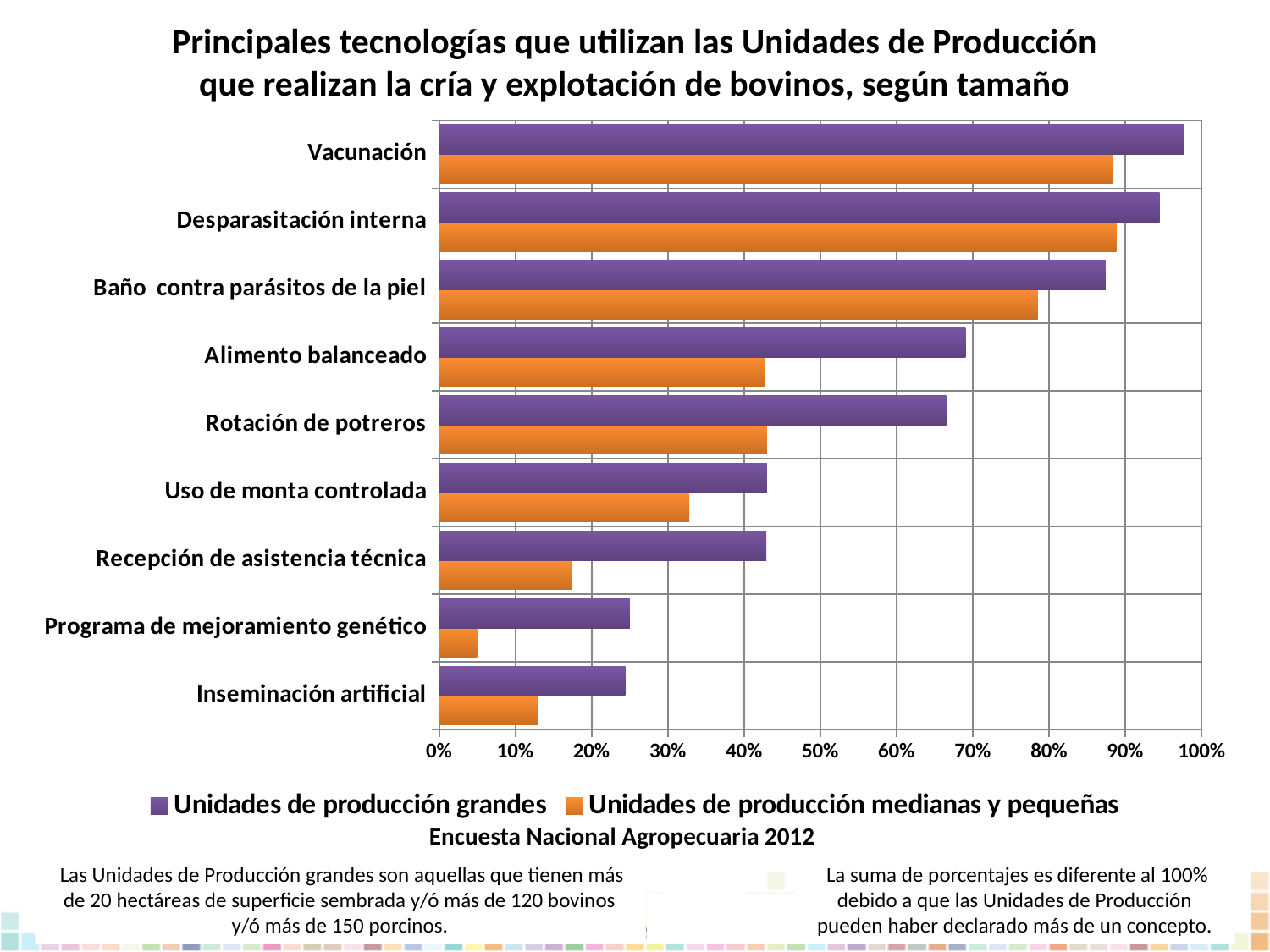
How many series does the legend list? 2 What is the data source cited below the chart? Encuesta Nacional Agropecuaria 2012 Which technology has the lowest value for Unidades de producción medianas y pequeñas? Programa de mejoramiento genético Which colour represents Unidades de producción grandes in the chart? Purple Is the value for Alimento balanceado among Unidades de producción medianas y pequeñas greater or less than 50%? less For Alimento balanceado, which series has the larger value: Unidades de producción grandes or Unidades de producción medianas y pequeñas? Unidades de producción grandes What kind of chart is shown on the slide? Bar chart How many technologies (categories) are listed on the chart? 9 Is the value for Recepción de asistencia técnica among Unidades de producción medianas y pequeñas greater or less than 20%? less Is the value for Vacunación among Unidades de producción grandes greater or less than 90%? greater Which technology has the highest value for Unidades de producción grandes? Vacunación